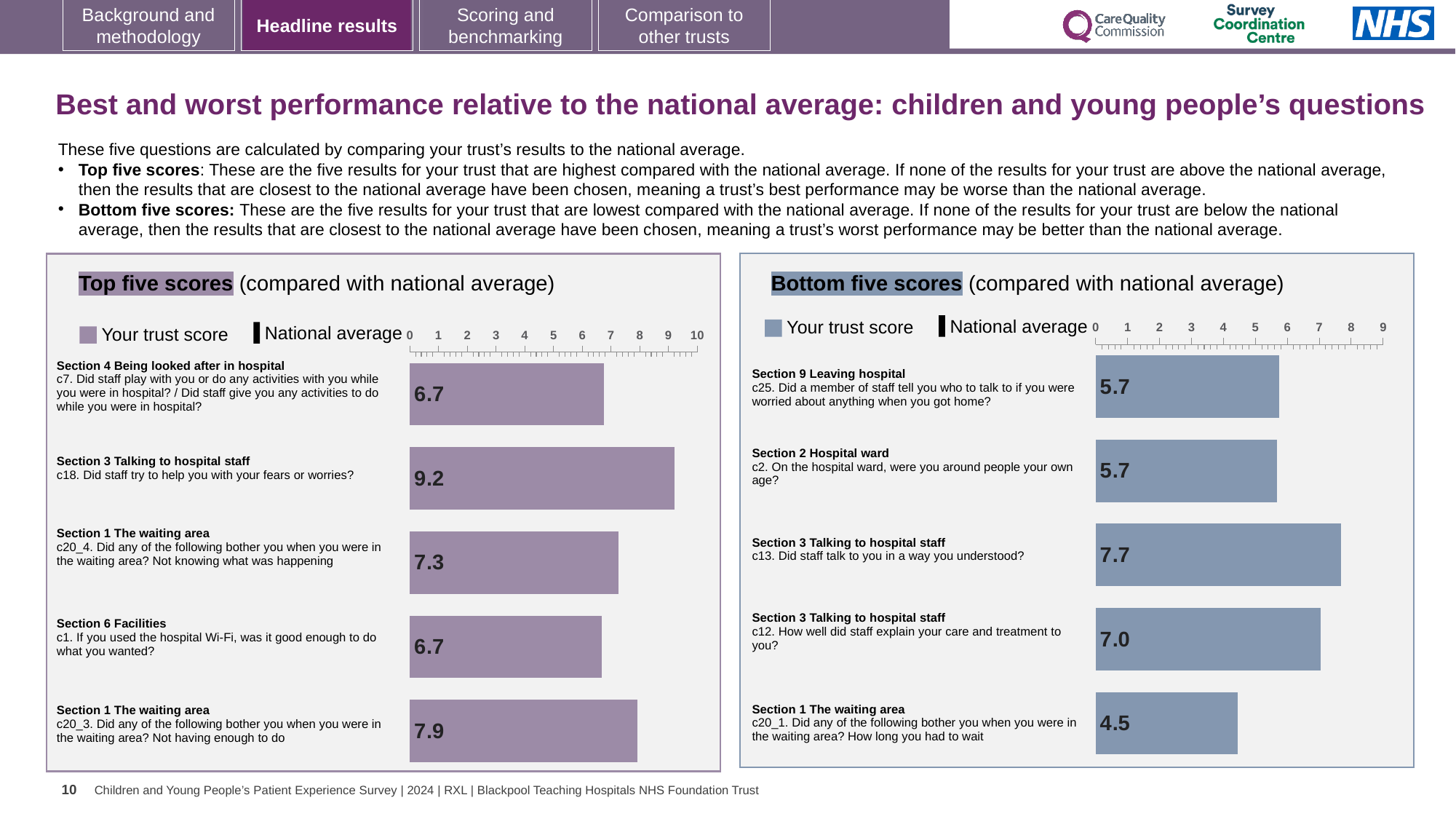
In the Top five scores chart, what is the trust score for c20_3 (Not having enough to do)? 7.9 In the Bottom five scores chart, which question has the highest trust score? c13. Did staff talk to you in a way you understood? In the Top five scores chart, what is the trust score for c18 (Did staff try to help you with your fears or worries?)? 9.2 What type of chart is the Top five scores chart? Bar chart In the Bottom five scores chart, which has the larger trust score: c13 or c12? c13 In the Bottom five scores chart, what is the trust score for c20_1 (How long you had to wait)? 4.5 In the Bottom five scores chart, what is the difference between the trust scores for c13 and c20_1? 3.2 In the Bottom five scores chart, which question has the lowest trust score? c20_1. How long you had to wait How many bars are shown in the Top five scores chart? 5 In the Top five scores chart, which question has the highest trust score? c18. Did staff try to help you with your fears or worries? How many entries does the legend of the Bottom five scores chart list? 2 In the Top five scores chart, what is the difference between the trust scores for c18 and c7? 2.5